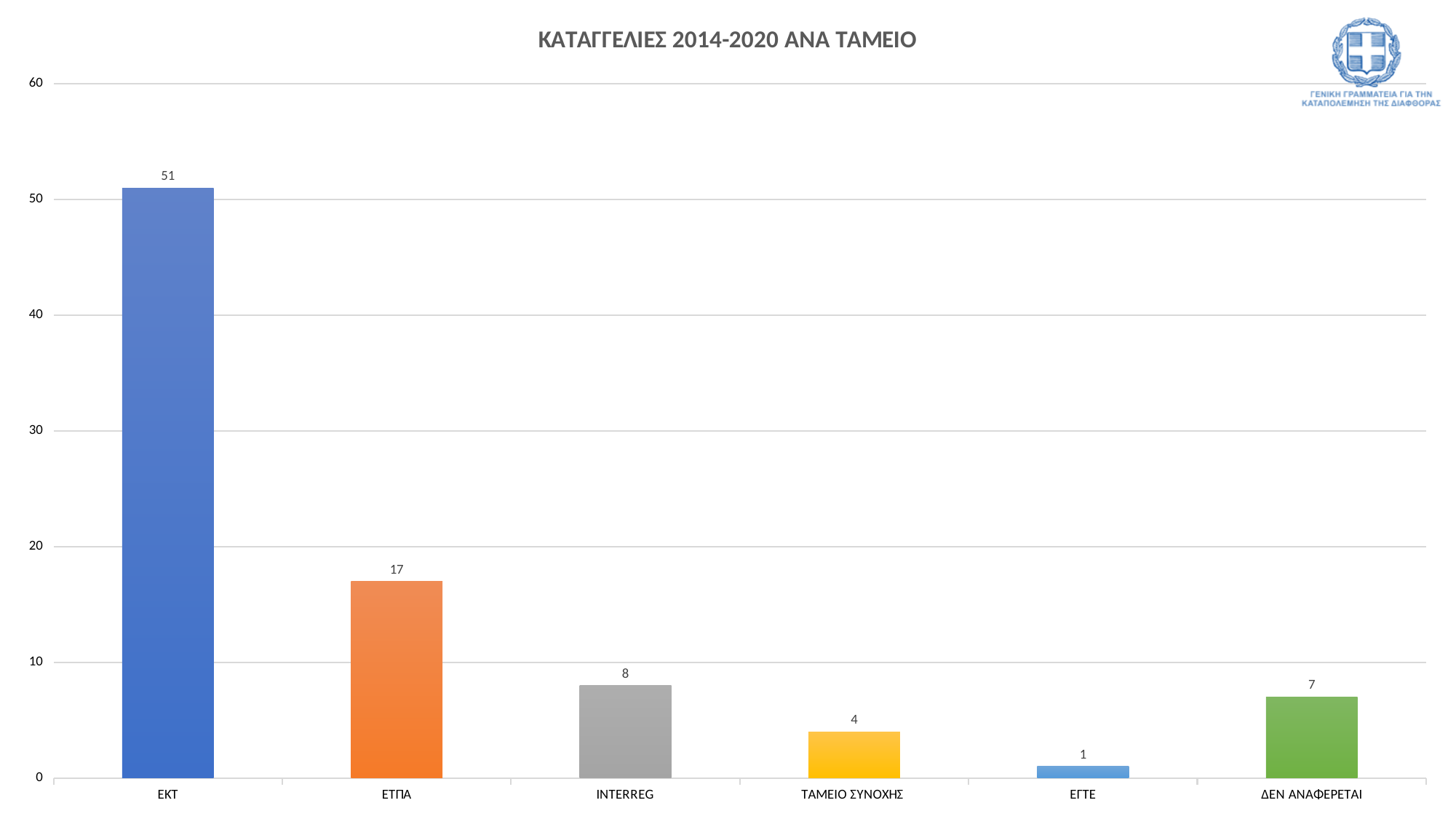
What is the value for INTERREG? 8 Which is larger, the value for INTERREG or the value for ΔΕΝ ΑΝΑΦΕΡΕΤΑΙ? INTERREG What kind of chart is shown on the slide? Bar chart How many categories are shown on the x axis? 6 Which category has the lowest value? ΕΓΤΕ What is the value for ΕΤΠΑ? 17 What is the value for ΤΑΜΕΙΟ ΣΥΝΟΧΗΣ? 4 What is the value for ΔΕΝ ΑΝΑΦΕΡΕΤΑΙ? 7 What is the value for ΕΚΤ? 51 Which category has the highest value? ΕΚΤ What is the title of the chart? ΚΑΤΑΓΓΕΛΙΕΣ 2014-2020 ΑΝΑ ΤΑΜΕΙΟ What is the difference between the values for ΕΚΤ and ΕΤΠΑ? 34